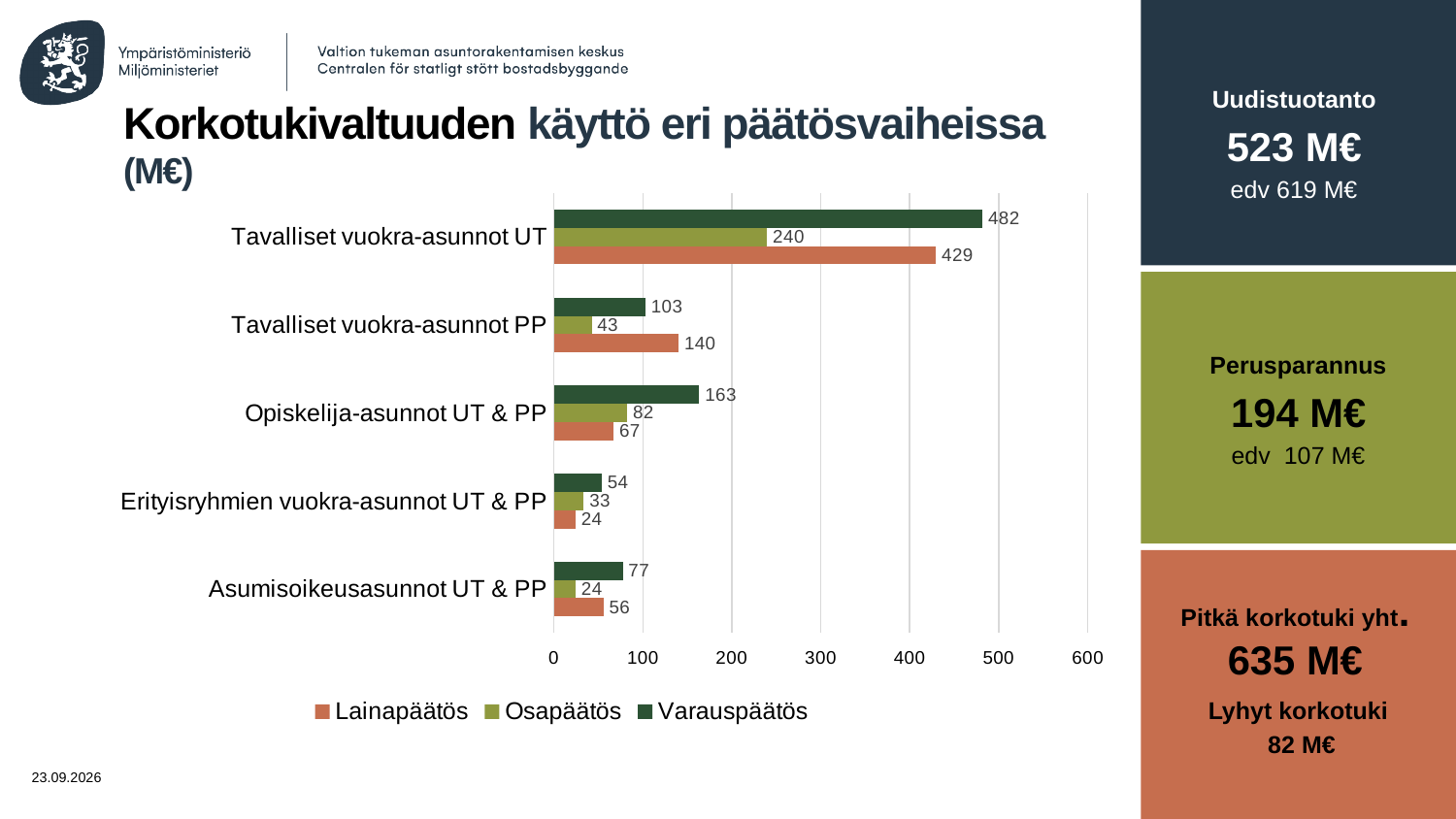
What kind of chart is shown on the slide? Bar chart What is the difference between the Varauspäätös and Lainapäätös values for Tavalliset vuokra-asunnot UT? 53 How many series does the legend list? 3 For Opiskelija-asunnot UT & PP, which is larger: the Varauspäätös value or the Lainapäätös value? Varauspäätös What is the Osapäätös value for Opiskelija-asunnot UT & PP? 82 How many categories are shown on the chart? 5 Which series is shown in orange in the legend? Lainapäätös Which category has the lowest Varauspäätös value? Erityisryhmien vuokra-asunnot UT & PP What is the Lainapäätös value for Asumisoikeusasunnot UT & PP? 56 Which category has the highest Lainapäätös value? Tavalliset vuokra-asunnot UT What is the Varauspäätös value for Tavalliset vuokra-asunnot UT? 482 What is the Lainapäätös value for Tavalliset vuokra-asunnot PP? 140